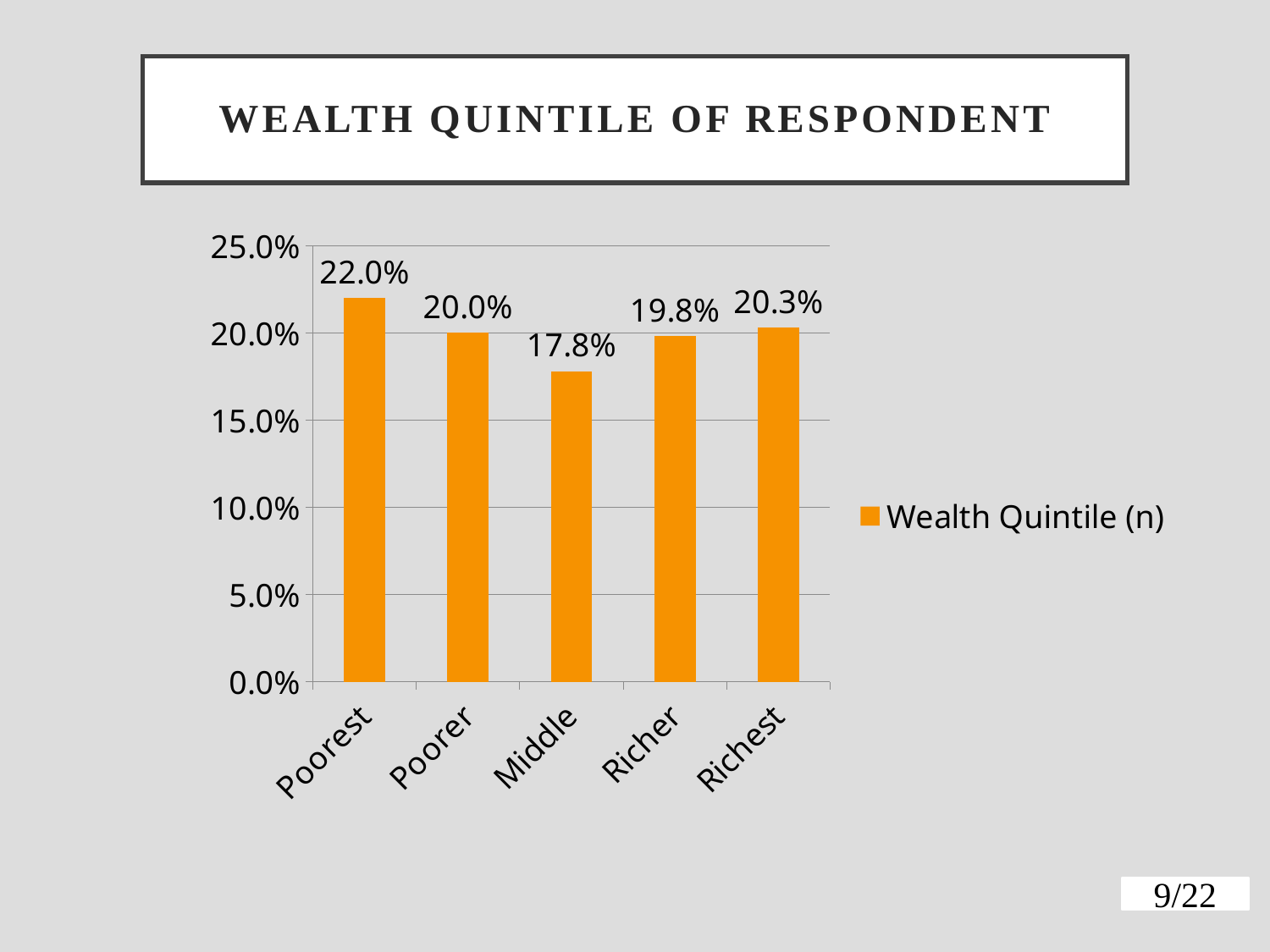
How many wealth quintile categories are shown on the x axis? 5 What series name does the legend list? Wealth Quintile (n) What kind of chart is shown on the slide? bar chart Is the value for Richer greater or less than 15.0%? greater What is the difference between the values for Richest and Richer? 0.5% Which wealth quintile has the lowest value? Middle What is the value for Poorest? 22.0% What is the value for Middle? 17.8% What is the value for Richest? 20.3% Which is larger, the value for Poorest or the value for Poorer? Poorest What is the difference between the values for Poorest and Middle? 4.2% Which wealth quintile has the highest value? Poorest